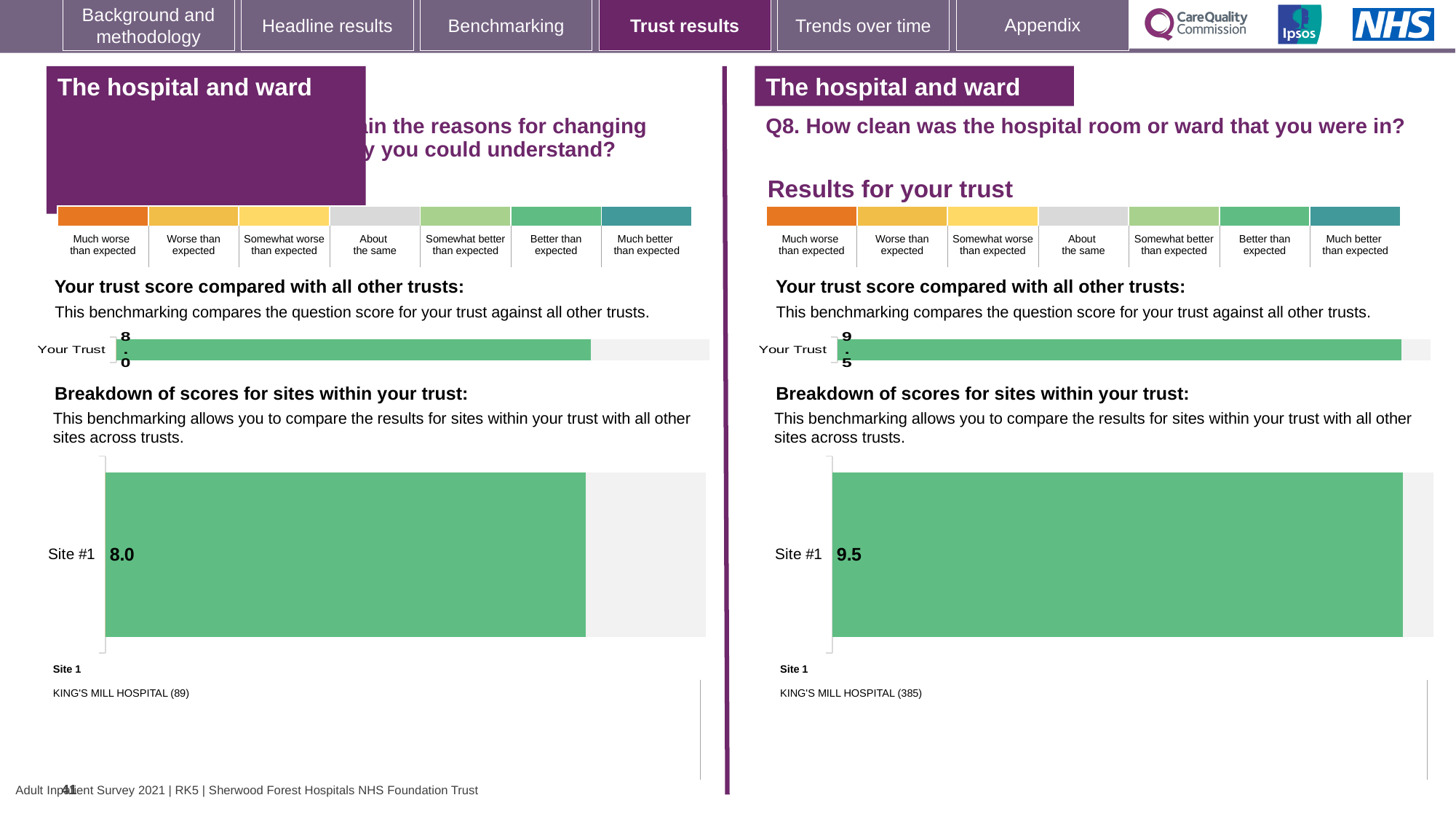
What type of chart is used to show the Site #1 score in the right-hand breakdown chart (Q8)? Bar chart On the left-hand side of the slide, what is the score shown for Your Trust in the trust comparison bar chart? 8.0 Which hospital is listed as Site 1 beneath the right-hand breakdown chart (Q8)? KING'S MILL HOSPITAL (385) What type of chart is used to show the Your Trust score on the left-hand side of the slide? Bar chart What is the difference between the Site #1 score in the right-hand breakdown chart (Q8) and the Site #1 score in the left-hand breakdown chart? 1.5 On the right-hand side of the slide (Q8. How clean was the hospital room or ward that you were in?), what is the score shown for Your Trust? 9.5 In the right-hand 'Breakdown of scores for sites within your trust' chart (Q8), what is the score for Site #1? 9.5 What colour is the Site #1 bar in the left-hand 'Breakdown of scores for sites within your trust' chart? Green How many sites are shown in the left-hand 'Breakdown of scores for sites within your trust' chart? 1 Which is larger: the Site #1 score in the left-hand breakdown chart or the Site #1 score in the right-hand breakdown chart (Q8)? The right-hand chart (Q8) How many sites are shown in the right-hand 'Breakdown of scores for sites within your trust' chart (Q8)? 1 In the left-hand 'Breakdown of scores for sites within your trust' chart, what is the score for Site #1? 8.0